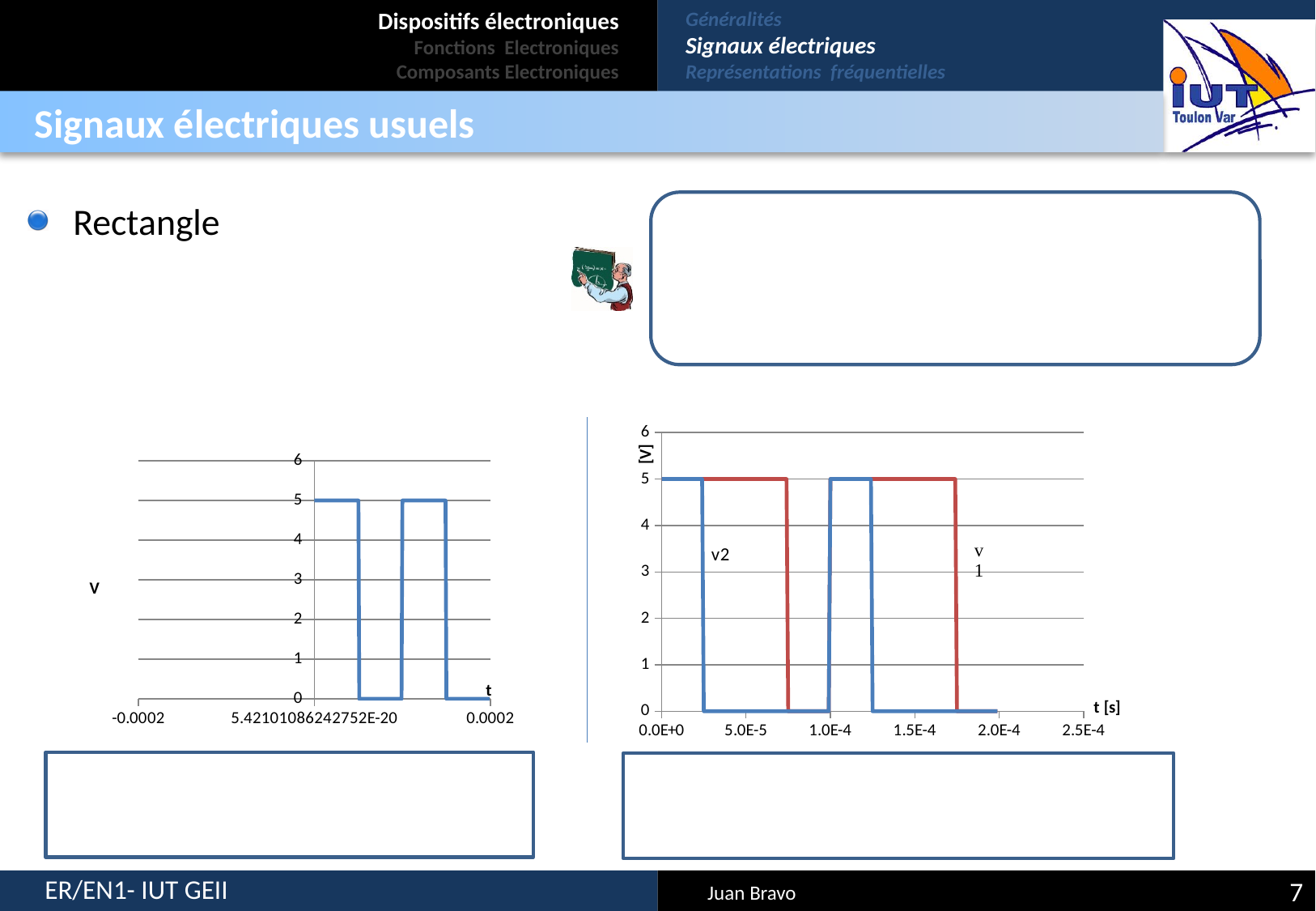
On the right chart, what is the largest tick value shown on the x axis? 2.5E-4 On the left chart, what is the lowest value the signal reaches? 0 On the right chart, what is the low level of signal v2? 0 On the right chart, what is the high level of signal v1? 5 On the left chart, what is the highest value the signal reaches? 5 On the right chart, is the high level of v2 greater or less than 3? greater On the left chart, what is the difference between the high level and the low level of the signal? 5 On the right chart, which signal drops to 0 first, v1 or v2? v2 On the right chart, which signal is drawn in red? v1 What kind of chart is the left chart on the slide? line chart On the left chart, is the high level of the signal greater or less than 4? greater On the right chart, how many signals are plotted? 2